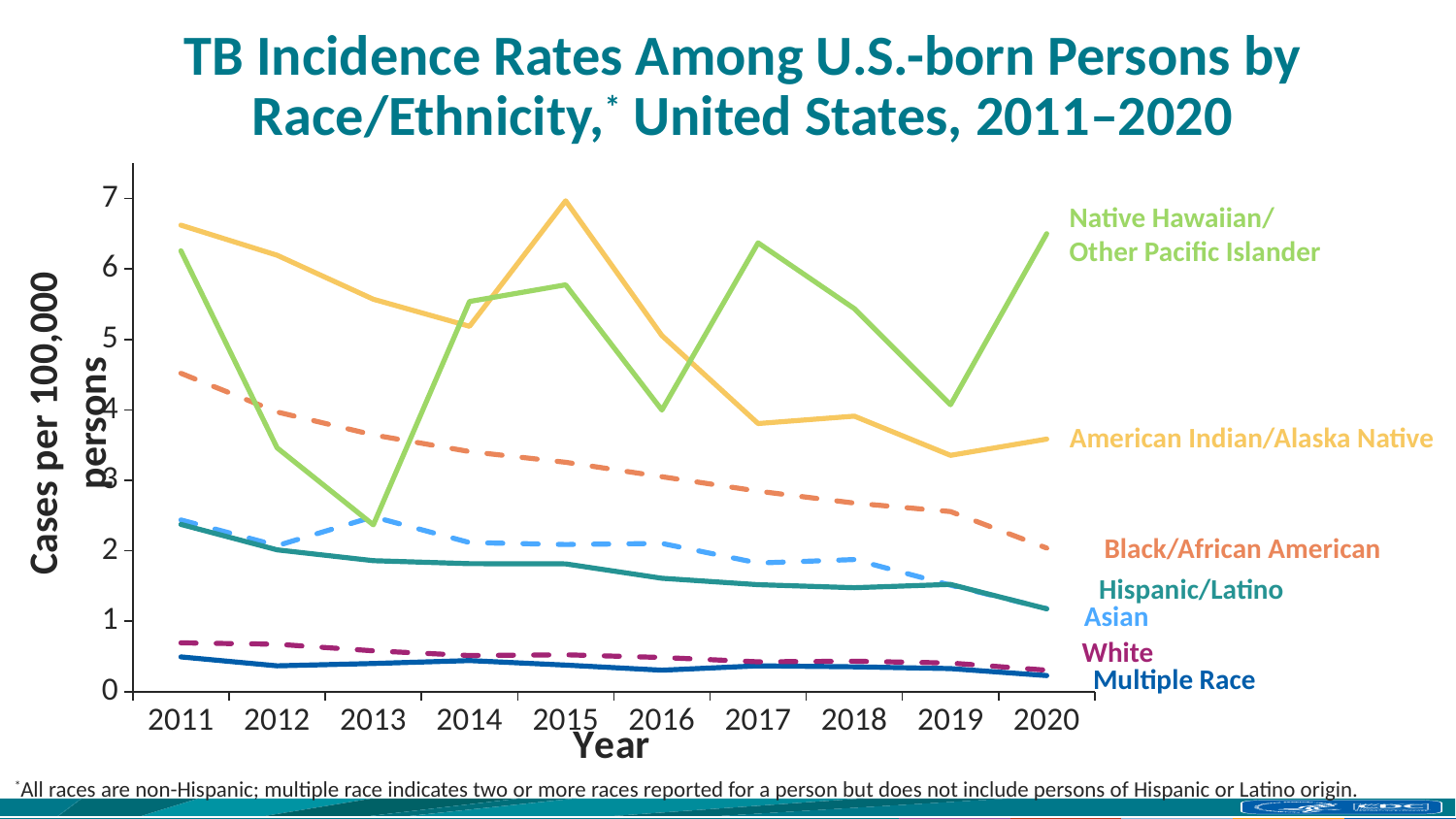
What is the label on the y axis of the chart? Cases per 100,000 persons Which race/ethnicity group has the highest TB incidence rate in 2011? American Indian/Alaska Native In 2012, which group has the higher TB incidence rate: Native Hawaiian/Other Pacific Islander or American Indian/Alaska Native? American Indian/Alaska Native Does the TB incidence rate for Black/African American persons rise or fall from 2011 to 2020? Fall How many years are shown along the x axis of the chart? 10 Which race/ethnicity group has the highest TB incidence rate in 2020? Native Hawaiian/Other Pacific Islander How many race/ethnicity groups are plotted as lines on the chart? 7 Is the TB incidence rate for American Indian/Alaska Native persons in 2019 greater or less than 3? greater What kind of chart is shown on the slide? Line chart Which race/ethnicity group has the lowest TB incidence rate in 2011? Multiple Race Is the TB incidence rate for Native Hawaiian/Other Pacific Islander persons in 2013 greater or less than 3? less Is the TB incidence rate for Black/African American persons in 2011 greater or less than 4? greater